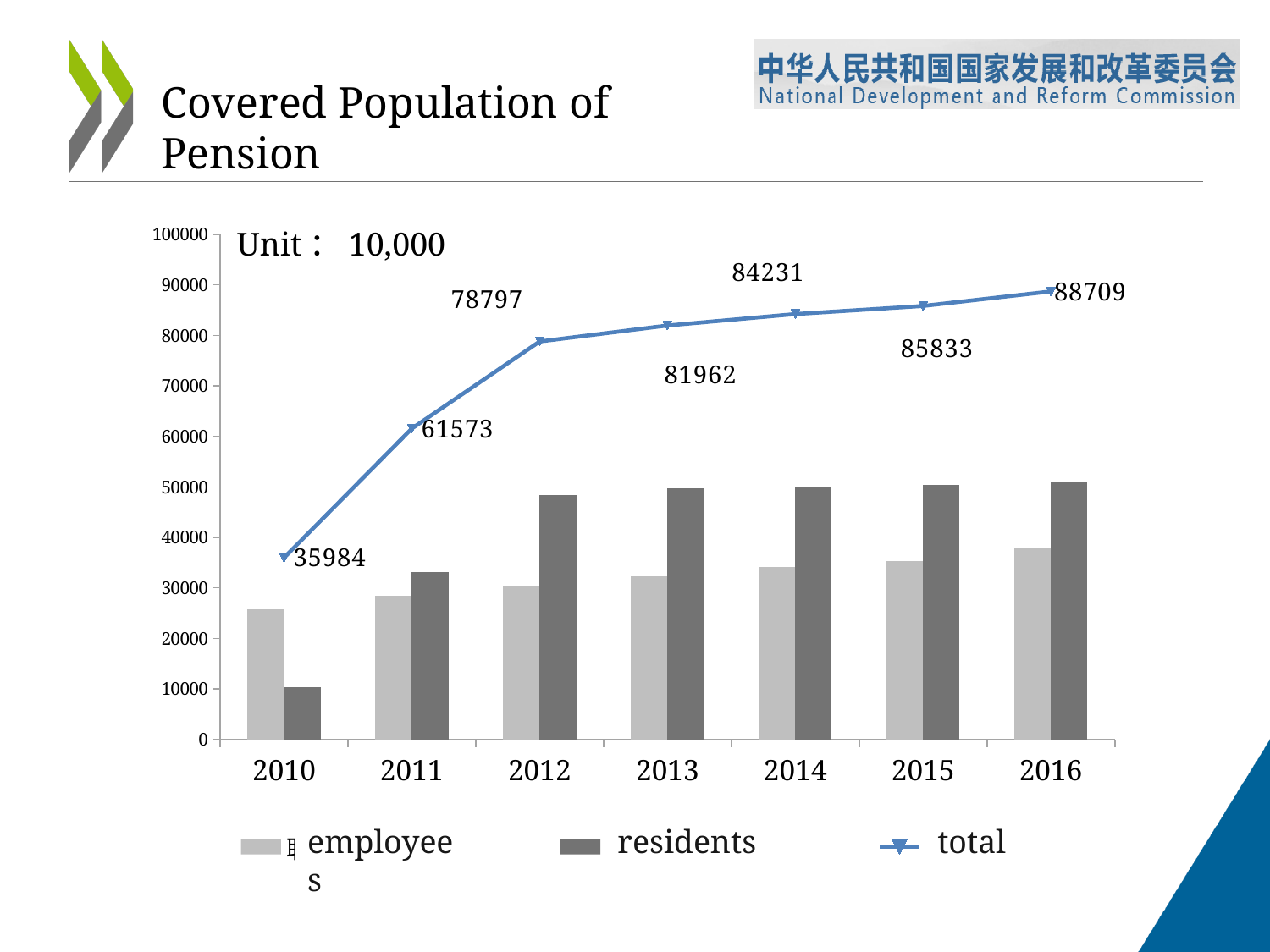
In which year is the total covered population lowest? 2010 Is the value for residents in 2010 greater or less than 20000? less By how much did the total increase from 2010 to 2016? 52725 How many series does the legend list? 3 How many years are shown on the x axis? 7 What is the total covered population of pension in 2010? 35984 By how much did the total increase from 2011 to 2012? 17224 Does the total line rise or fall from 2010 to 2016? rises What is the total covered population of pension in 2016? 88709 In which year is the total covered population highest? 2016 What is the total covered population of pension in 2013? 81962 In 2016, which is larger, the employees bar or the residents bar? residents